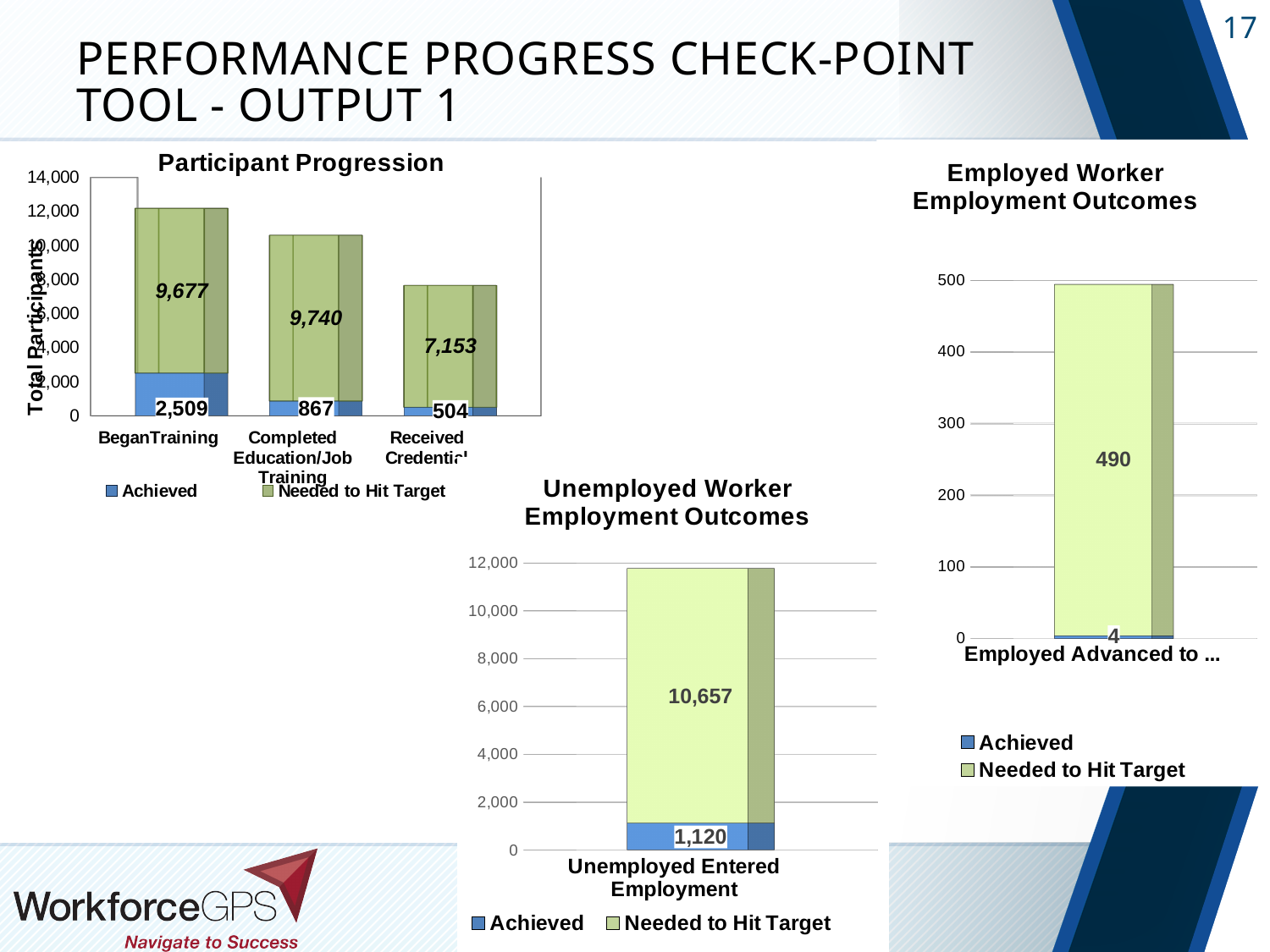
In the Unemployed Worker Employment Outcomes chart, what is the Needed to Hit Target value for Unemployed Entered Employment? 10,657 In the Participant Progression chart, which category has the highest Achieved value? Began Training How many series does the legend of the Employed Worker Employment Outcomes chart list? 2 In the Participant Progression chart, what is the Achieved value for Began Training? 2,509 In the Participant Progression chart, which category has the lowest Needed to Hit Target value? Received Credential In the Participant Progression chart, what is the Achieved value for Received Credential? 504 In the Participant Progression chart, what is the total of the stacked bar for Received Credential? 7,657 How many categories are shown on the x axis of the Participant Progression chart? 3 In the Unemployed Worker Employment Outcomes chart, what is the total of the stacked bar for Unemployed Entered Employment? 11,777 In the Participant Progression chart, what is the difference between the Achieved values for Began Training and Completed Education/Job Training? 1,642 In the Employed Worker Employment Outcomes chart, what is the Achieved value? 4 In the Participant Progression chart, what is the Needed to Hit Target value for Completed Education/Job Training? 9,740